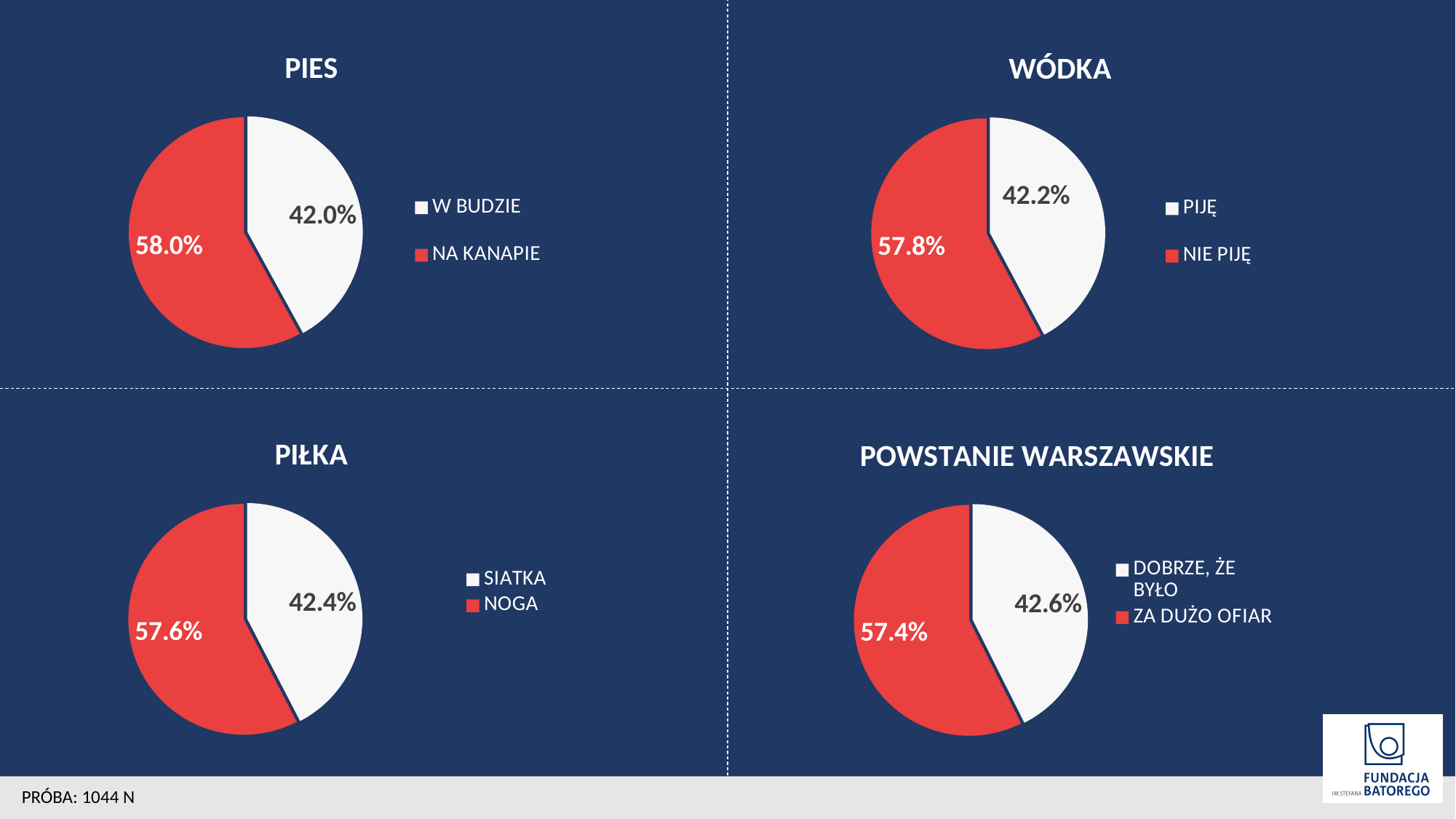
In the POWSTANIE WARSZAWSKIE chart, which slice is the smallest? DOBRZE, ŻE BYŁO In the WÓDKA chart, what share is labelled for PIJĘ? 42.2% In the PIŁKA chart, what share is labelled for SIATKA? 42.4% In the POWSTANIE WARSZAWSKIE chart, what share is labelled for ZA DUŻO OFIAR? 57.4% In the PIES chart, what share is labelled for NA KANAPIE? 58.0% In the WÓDKA chart, which is larger, PIJĘ or NIE PIJĘ? NIE PIJĘ In the PIŁKA chart, which slice is the largest? NOGA In the WÓDKA chart, what share is labelled for NIE PIJĘ? 57.8% In the PIES chart, what is the difference in percentage points between NA KANAPIE and W BUDZIE? 16.0 percentage points How many slices does the POWSTANIE WARSZAWSKIE chart have? 2 In the PIES chart, what share is labelled for W BUDZIE? 42.0% What type of chart is the PIŁKA chart? Pie chart